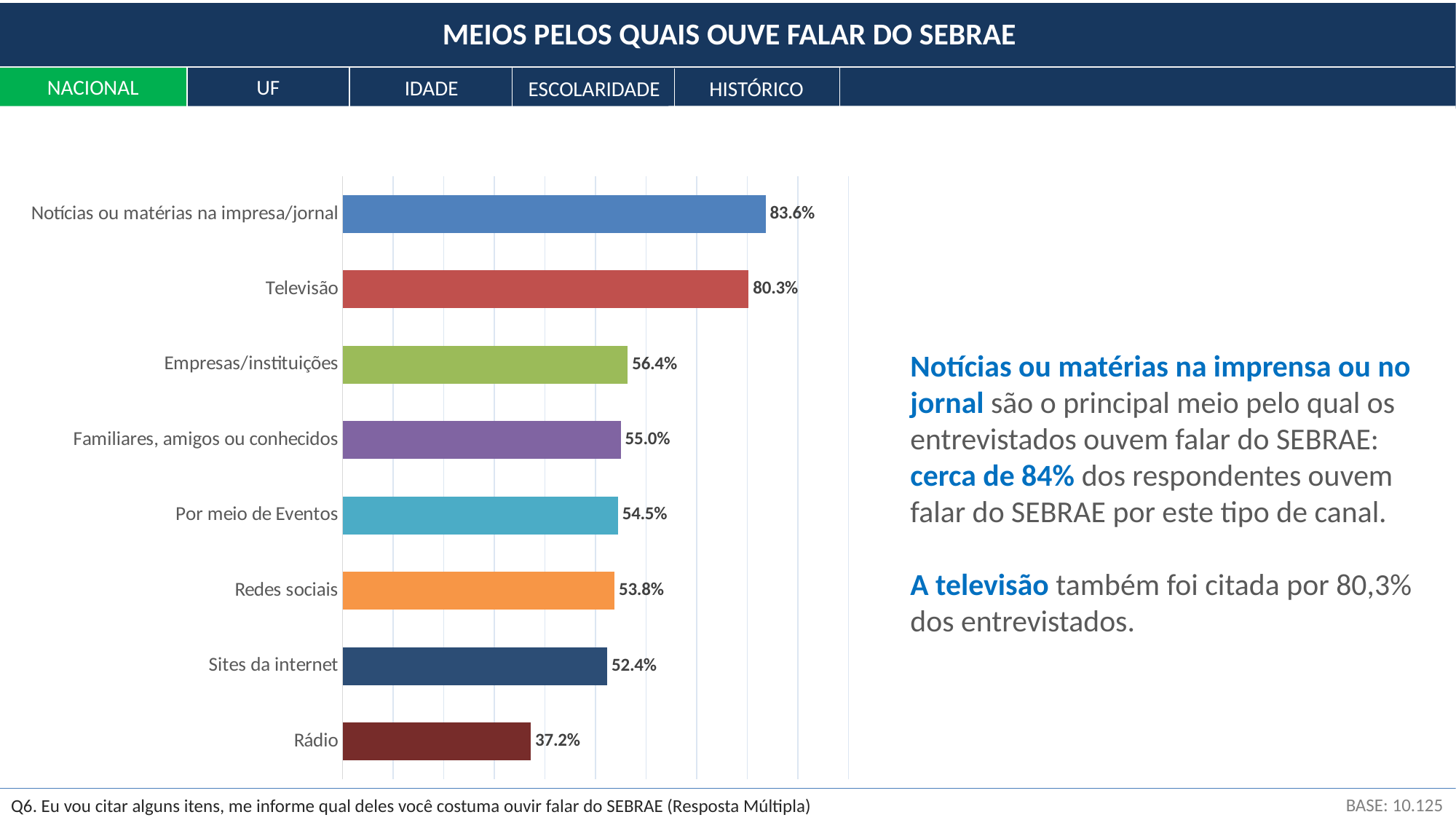
What is the value for Rádio? 37.2% Which is larger, the value for Empresas/instituições or the value for Por meio de Eventos? Empresas/instituições What kind of chart is shown on the slide? Bar chart Which category has the lowest value? Rádio Which category has the highest value? Notícias ou matérias na impresa/jornal What colour is the bar for Rádio? Dark red What is the title of the slide? MEIOS PELOS QUAIS OUVE FALAR DO SEBRAE What is the value for Televisão? 80.3% How many categories are shown in the chart? 8 What is the difference between the values for Sites da internet and Rádio? 15.2% What is the difference between the values for Notícias ou matérias na impresa/jornal and Televisão? 3.3% What is the value for Redes sociais? 53.8%